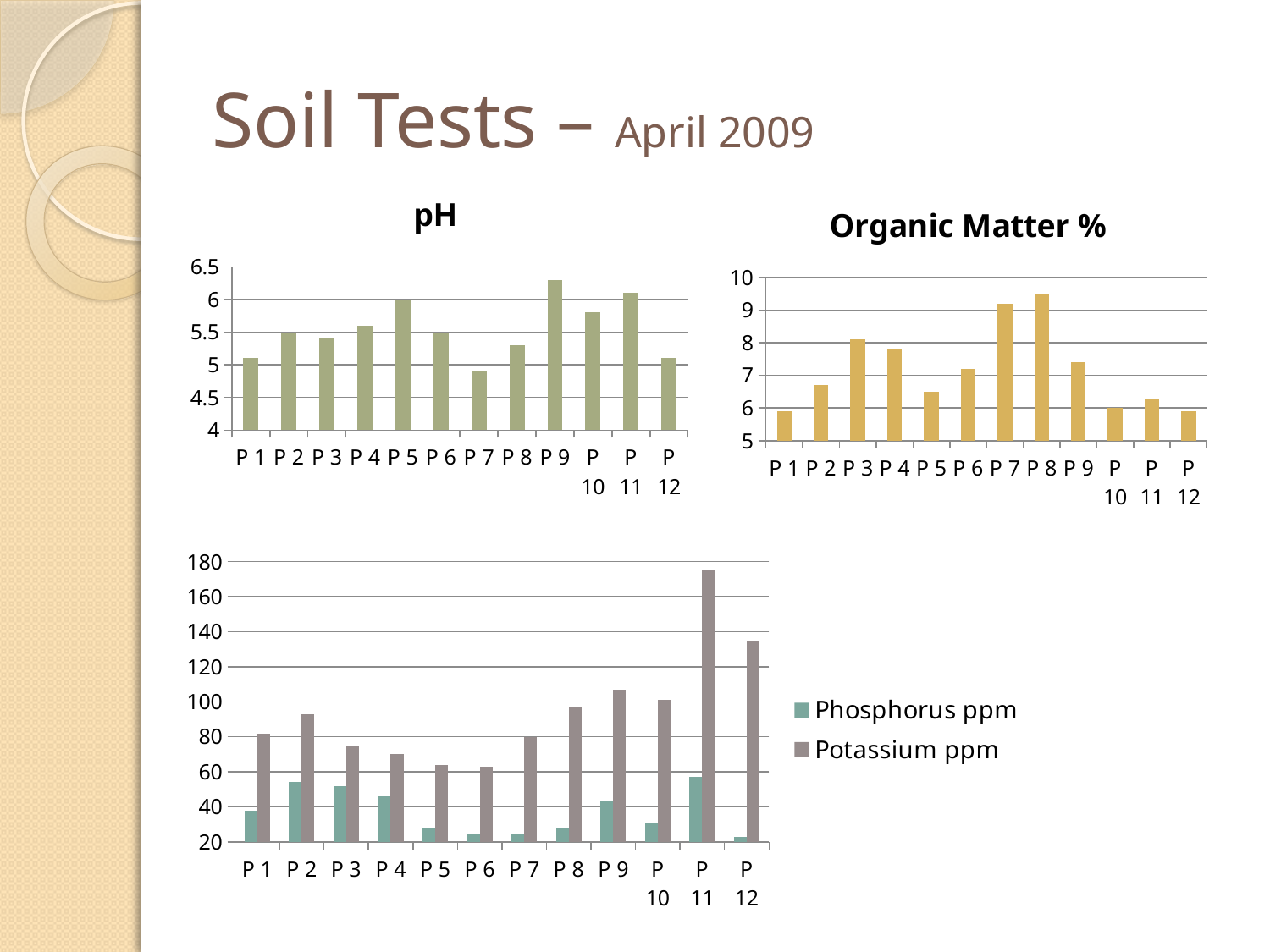
What kind of chart is the pH chart? bar chart In the pH chart, is the value for P 9 greater or less than 6? greater In the bottom chart, is the Potassium ppm value for P 11 greater or less than 160? greater In the Organic Matter % chart, which is larger, the value for P 3 or the value for P 5? P 3 In the bottom chart, which is larger, the Potassium ppm value for P 11 or for P 12? P 11 In the pH chart, which plot has the highest pH? P 9 In the bottom chart, which plot has the highest Potassium ppm? P 11 In the bottom chart, how many series does the legend list? 2 In the Organic Matter % chart, is the value for P 7 greater or less than 9? greater In the Organic Matter % chart, which plot has the highest organic matter? P 8 In the pH chart, how many plots (categories) are shown on the x axis? 12